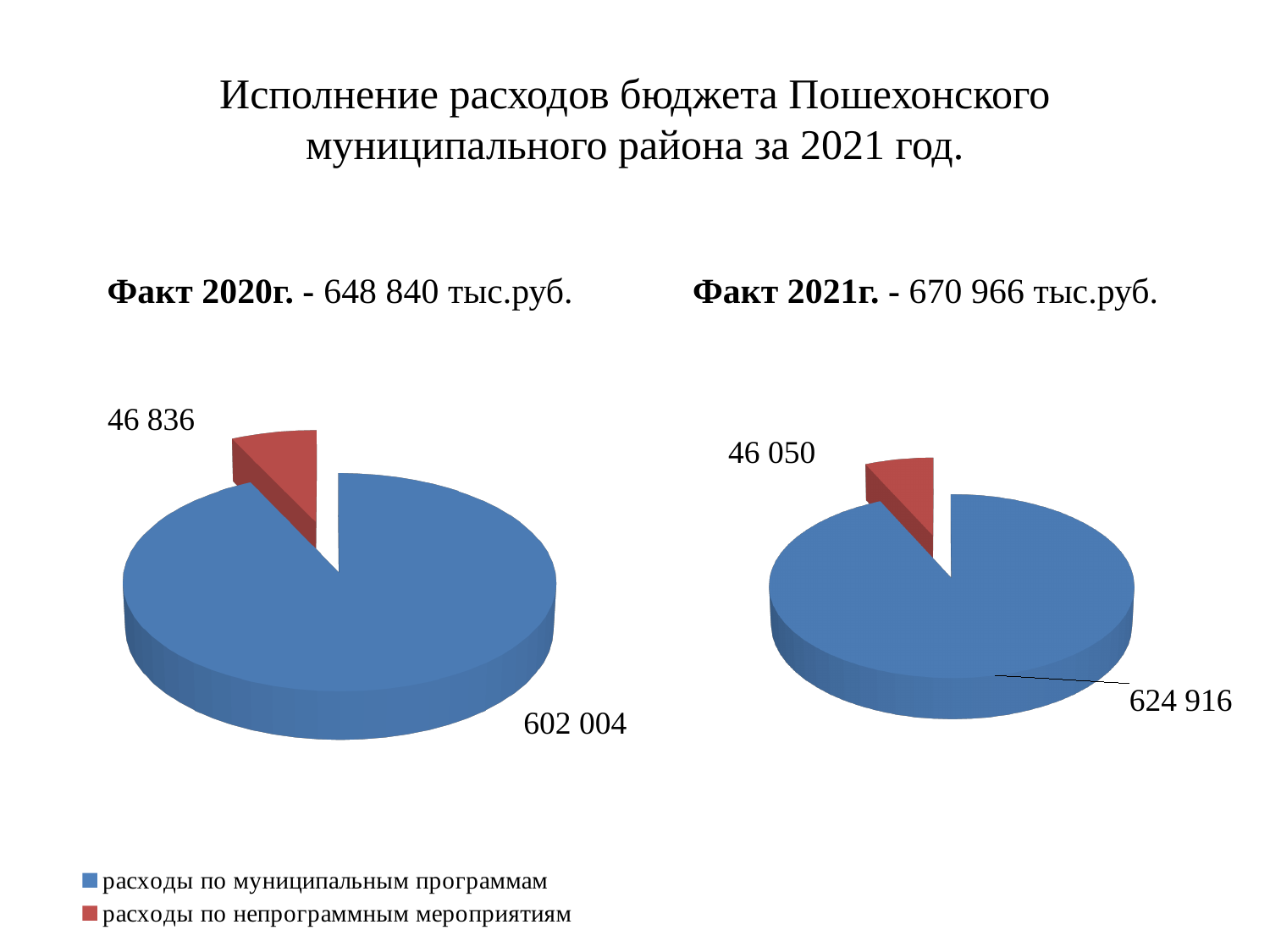
What is the difference between расходы по непрограммным мероприятиям in the 'Факт 2020г.' chart and in the 'Факт 2021г.' chart? 786 How many categories does the legend list? 2 In the 'Факт 2021г.' chart, which category has the largest slice? расходы по муниципальным программам What colour represents расходы по непрограммным мероприятиям in the charts? Red In the 'Факт 2020г.' chart, what is the value for расходы по непрограммным мероприятиям? 46 836 In the 'Факт 2020г.' chart, what is the value for расходы по муниципальным программам? 602 004 What is the difference between расходы по муниципальным программам in the 'Факт 2021г.' chart and in the 'Факт 2020г.' chart? 22 912 What type of chart is used on this slide? Pie chart In the 'Факт 2021г.' chart, what is the value for расходы по непрограммным мероприятиям? 46 050 Which is larger: расходы по непрограммным мероприятиям in the 'Факт 2020г.' chart or in the 'Факт 2021г.' chart? Факт 2020г. In the 'Факт 2021г.' chart, what is the value for расходы по муниципальным программам? 624 916 In the 'Факт 2020г.' chart, which category has the smallest slice? расходы по непрограммным мероприятиям